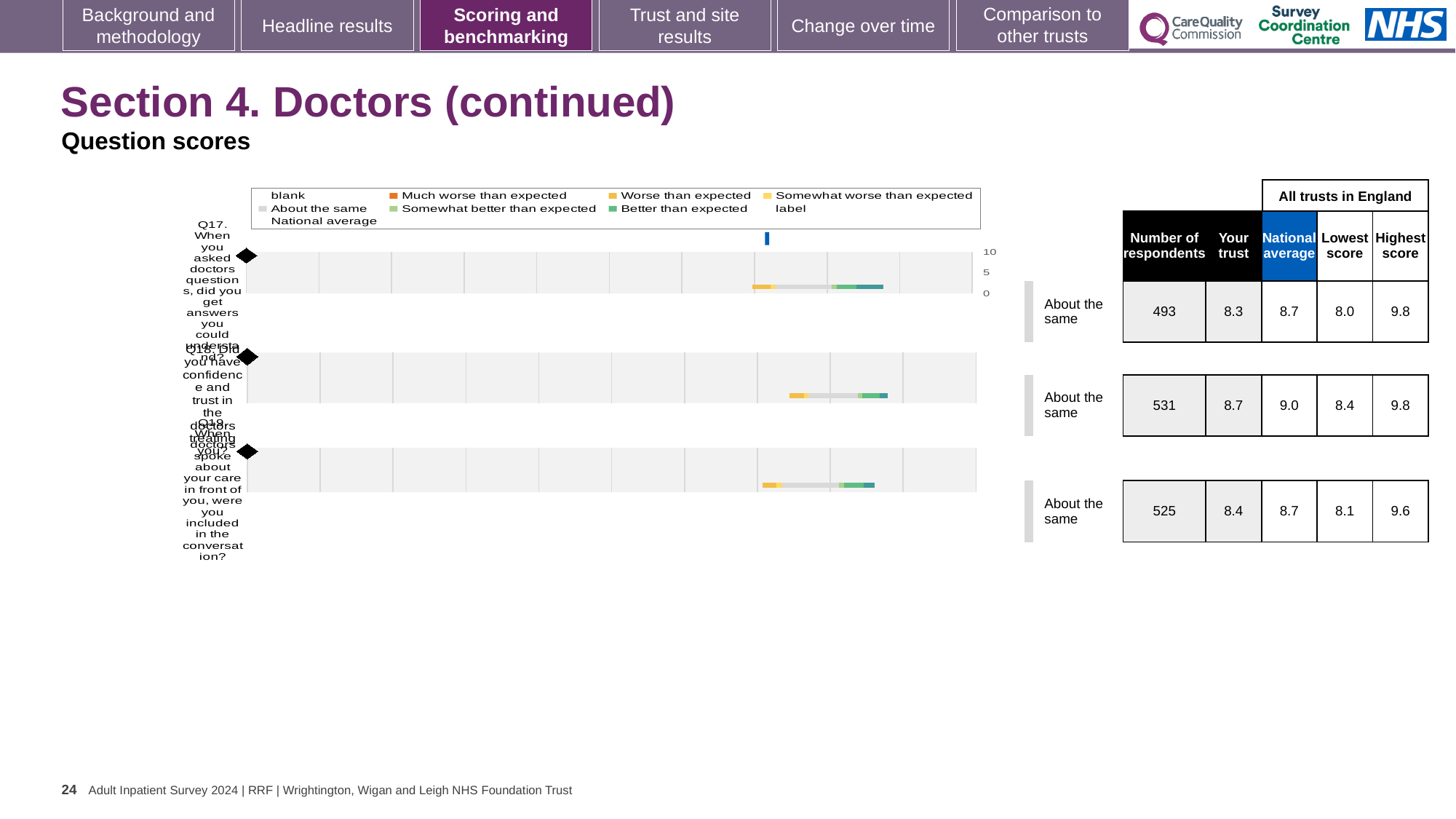
Which question has the lowest 'Your trust' score in the table beside the chart? Q17 In the table beside the chart, what is the 'Your trust' score for Q18? 8.7 In the table beside the chart, what is the number of respondents for Q17? 493 What is the highest value shown on the chart's score axis? 10 What benchmark category is shown next to each of the three question bars? About the same Which question has the largest number of respondents in the table beside the chart? Q18 Is the 'Your trust' score for Q19 larger or smaller than the 'Your trust' score for Q17? larger In the table beside the chart, what is the highest score across all trusts in England for Q19? 9.6 How many question rows (bars) are plotted in the chart? 3 What is the difference between the national average and the 'Your trust' score for Q18? 0.3 What kind of chart is used to show the question scores for Q17, Q18 and Q19? bar chart In the table beside the chart, what is the national average for Q19? 8.7